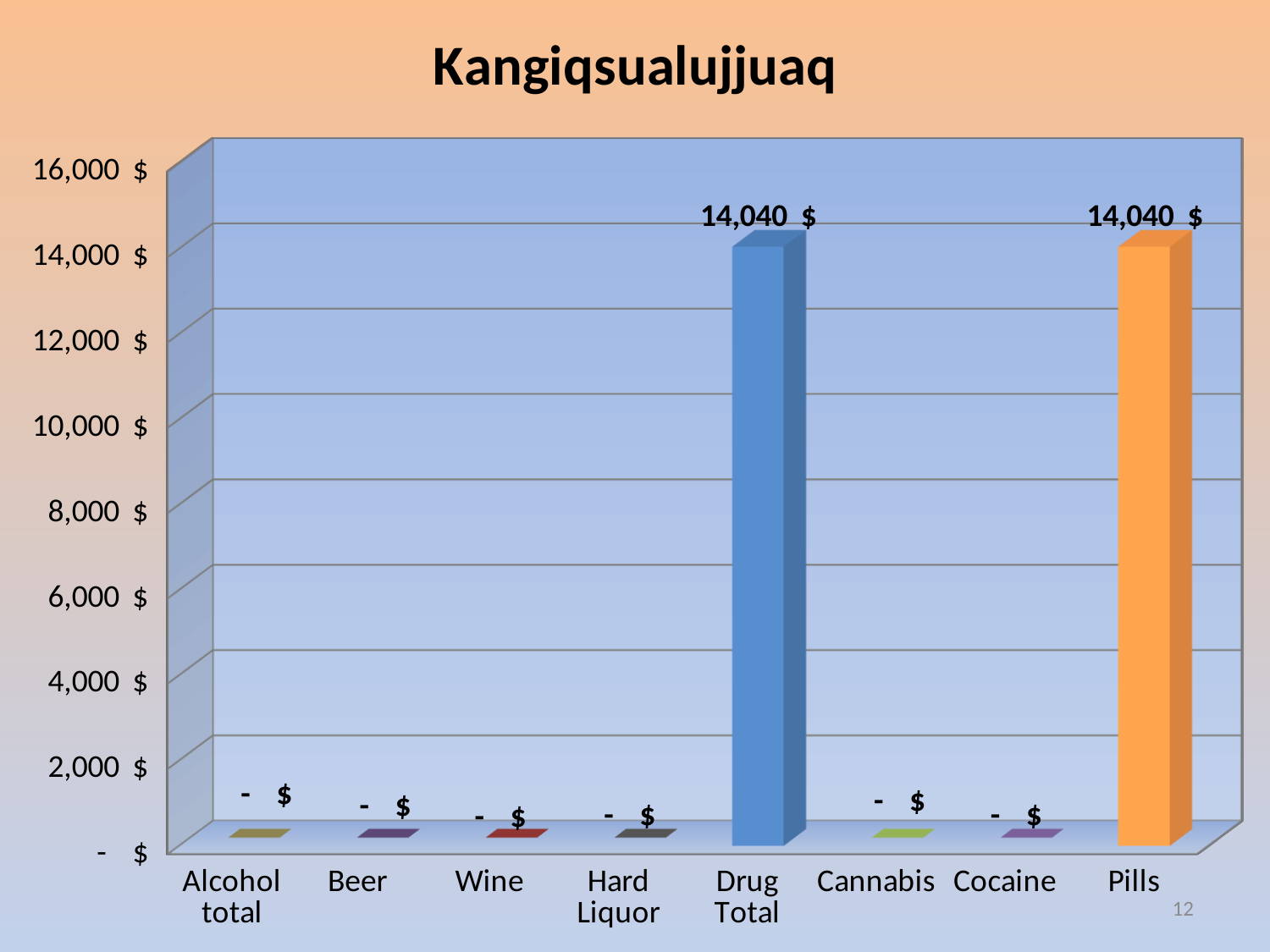
Which is larger, the value for Wine or the value for Drug Total? Drug Total What is the value for Pills? 14,040 $ What kind of chart is shown on the slide? Bar chart What is the value shown for Cannabis? - $ Is the value for Pills greater or less than 12,000 $? greater Is the value for Drug Total greater or less than 16,000 $? less What colour is the bar for Pills? Orange How many categories are shown on the x axis? 8 What is the difference between the values for Drug Total and Pills? 0 $ What is the title of the chart? Kangiqsualujjuaq What is the value shown for Beer? - $ What is the value for Drug Total? 14,040 $